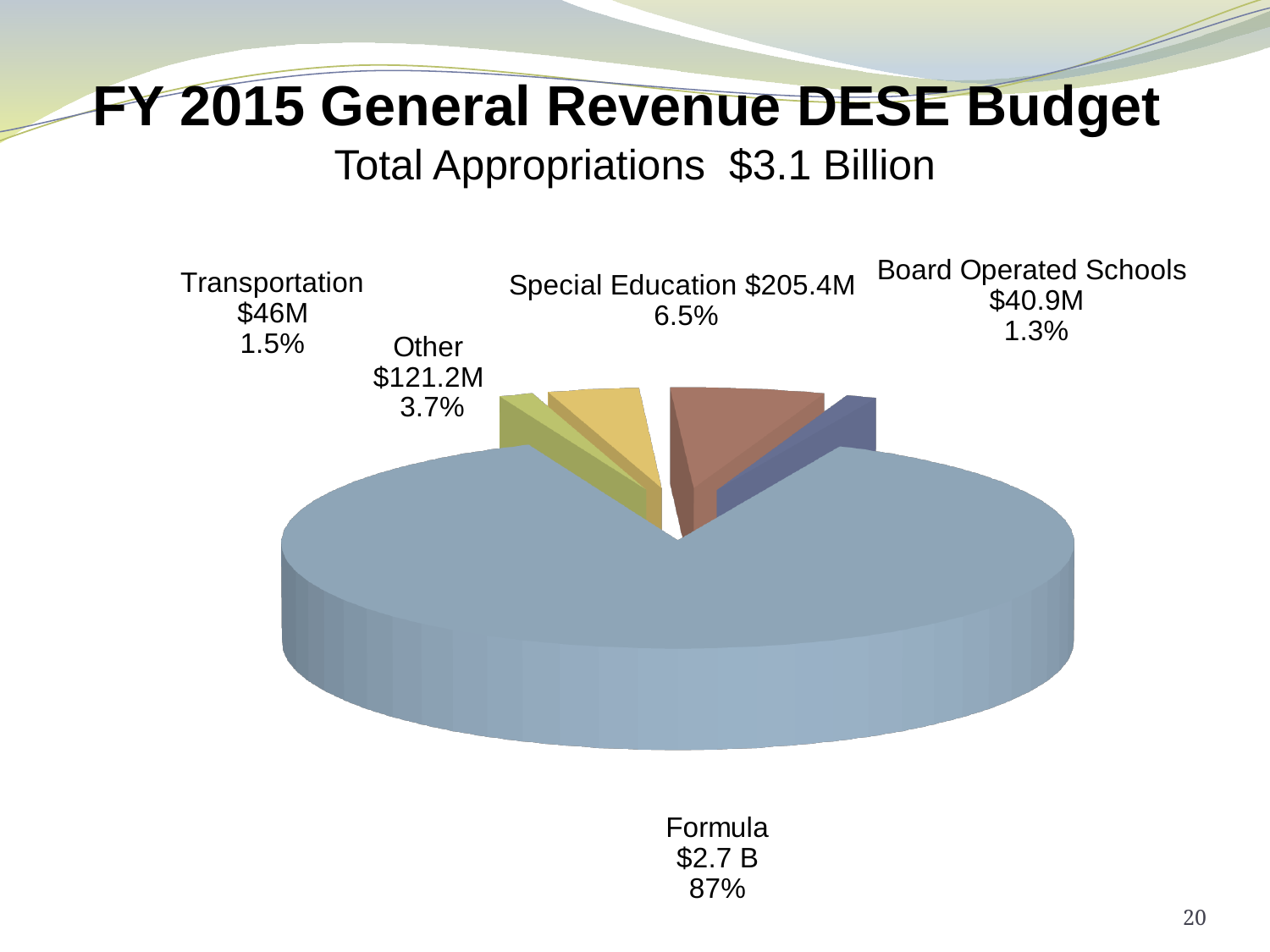
What kind of chart is shown on the slide? pie chart How many categories are shown in the pie chart? 5 What is the dollar amount for Special Education? $205.4M Which category has the smallest slice of the pie? Board Operated Schools What percentage share does Transportation have? 1.5% What is the dollar amount for Other? $121.2M Which category has the largest slice of the pie? Formula What is the dollar amount for Board Operated Schools? $40.9M Which is larger, the share for Special Education or the share for Other? Special Education What is the difference in percentage points between the Other share and the Transportation share? 2.2% What total appropriations amount is stated in the chart's subtitle? $3.1 Billion What percentage share does Formula have? 87%